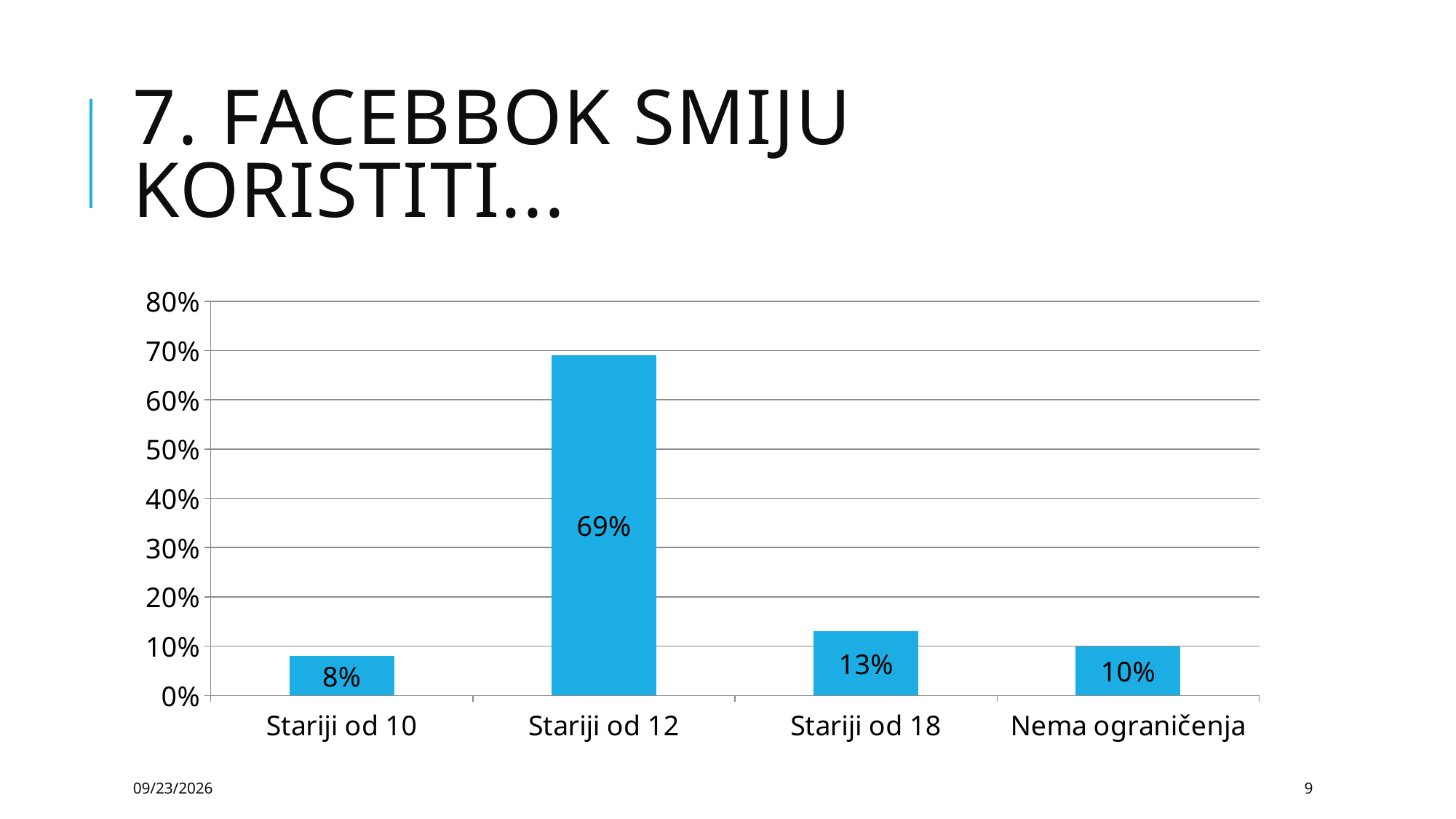
How many categories are shown on the x axis? 4 What is the difference between the values for Stariji od 18 and Nema ograničenja? 3% Which category has the highest value? Stariji od 12 What is the value for Stariji od 10? 8% What is the value for Stariji od 12? 69% What is the value for Stariji od 18? 13% Is the value for Stariji od 12 greater or less than 60%? greater What kind of chart is shown on the slide? bar chart What is the difference between the values for Stariji od 12 and Stariji od 18? 56% What is the value for Nema ograničenja? 10% Which is larger, the value for Stariji od 18 or the value for Stariji od 10? Stariji od 18 Which category has the lowest value? Stariji od 10